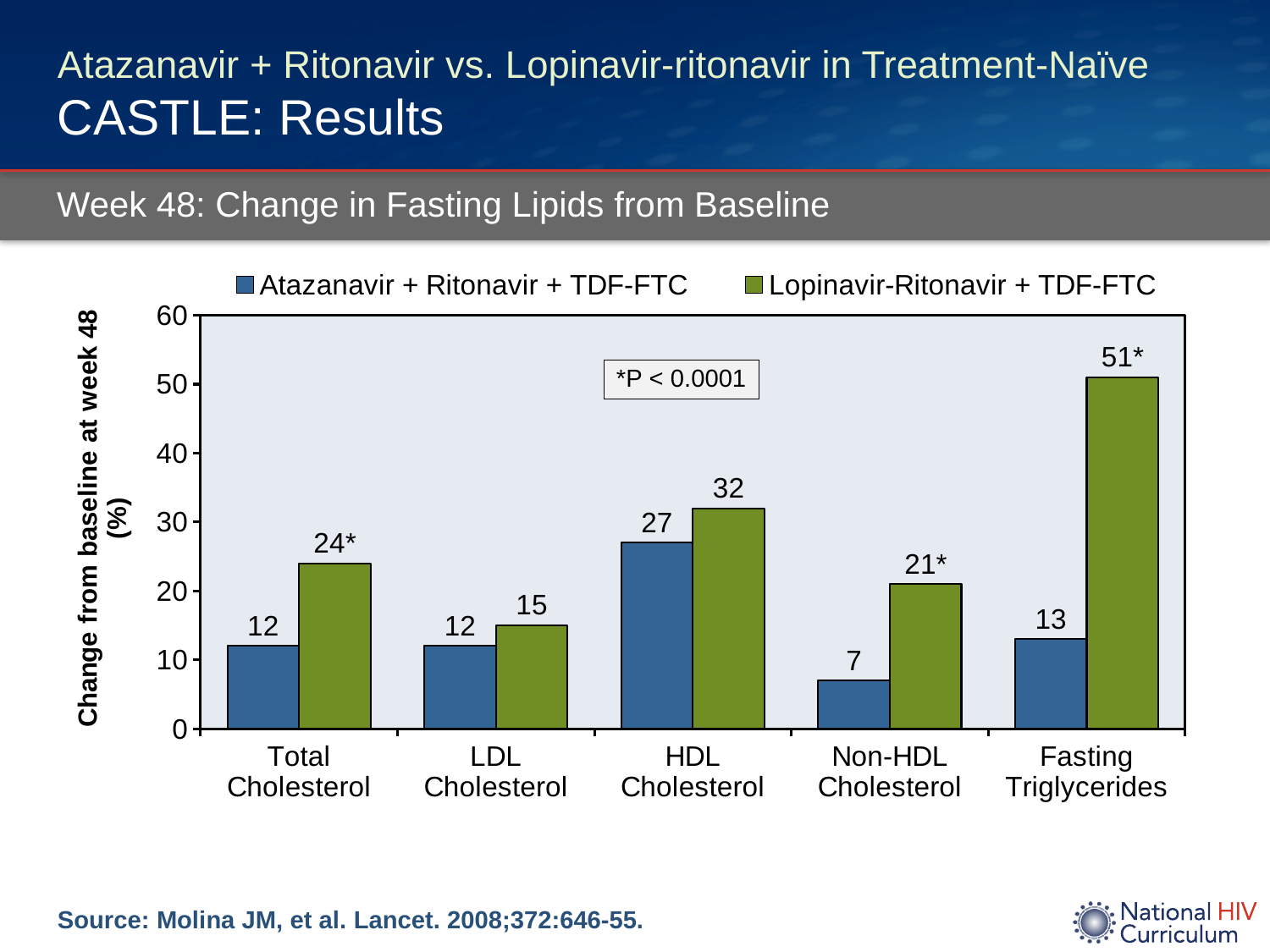
What is the change from baseline in Total Cholesterol for Atazanavir + Ritonavir + TDF-FTC? 12 What is the difference between the two treatment arms for LDL Cholesterol? 3 What kind of chart is shown on the slide? Bar chart What is the difference between the two treatment arms for Fasting Triglycerides? 38 What is the change from baseline in Non-HDL Cholesterol for Atazanavir + Ritonavir + TDF-FTC? 7 Which lipid category has the highest value for Lopinavir-Ritonavir + TDF-FTC? Fasting Triglycerides How many lipid categories are shown on the x axis? 5 What is the change from baseline in HDL Cholesterol for Lopinavir-Ritonavir + TDF-FTC? 32 Which lipid category has the lowest value for Atazanavir + Ritonavir + TDF-FTC? Non-HDL Cholesterol What is the change from baseline in Fasting Triglycerides for Lopinavir-Ritonavir + TDF-FTC? 51* For Non-HDL Cholesterol, which treatment arm has the larger change from baseline? Lopinavir-Ritonavir + TDF-FTC How many series does the legend list? 2